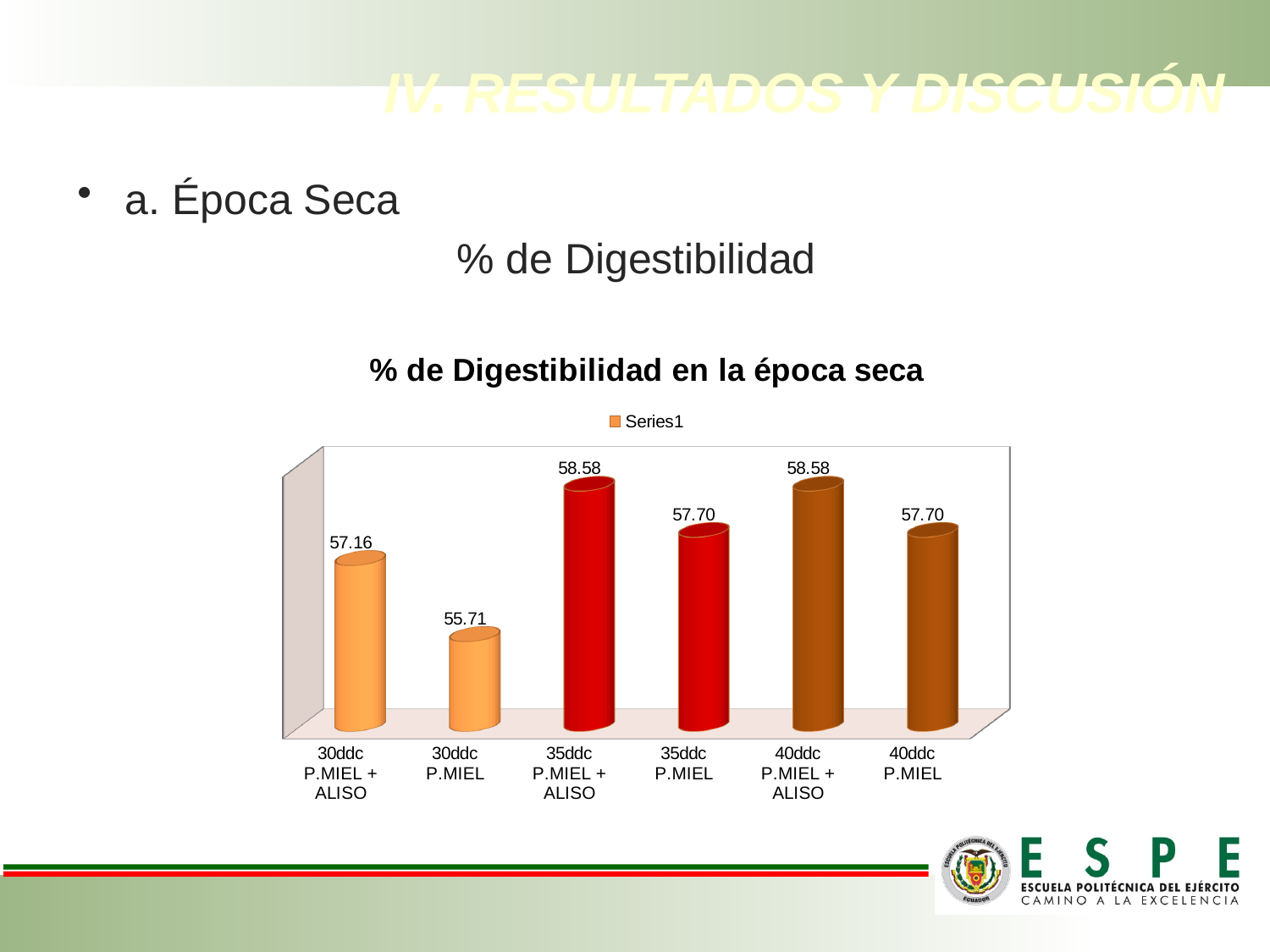
What type of chart is shown on the slide? Bar chart What is the value for 30ddc P.MIEL in the chart? 55.71 Which category has the lowest value in the chart? 30ddc P.MIEL What is the value for 30ddc P.MIEL + ALISO in the chart? 57.16 What is the difference between the values for 35ddc P.MIEL + ALISO and 35ddc P.MIEL? 0.88 What is the title of the chart? % de Digestibilidad en la época seca How many categories are shown in the chart? 6 What is the highest value shown in the chart? 58.58 What is the value for 40ddc P.MIEL? 57.70 What is the value for 35ddc P.MIEL + ALISO? 58.58 Which is larger, the value for 40ddc P.MIEL + ALISO or the value for 40ddc P.MIEL? 40ddc P.MIEL + ALISO What is the difference between the values for 30ddc P.MIEL + ALISO and 30ddc P.MIEL? 1.45